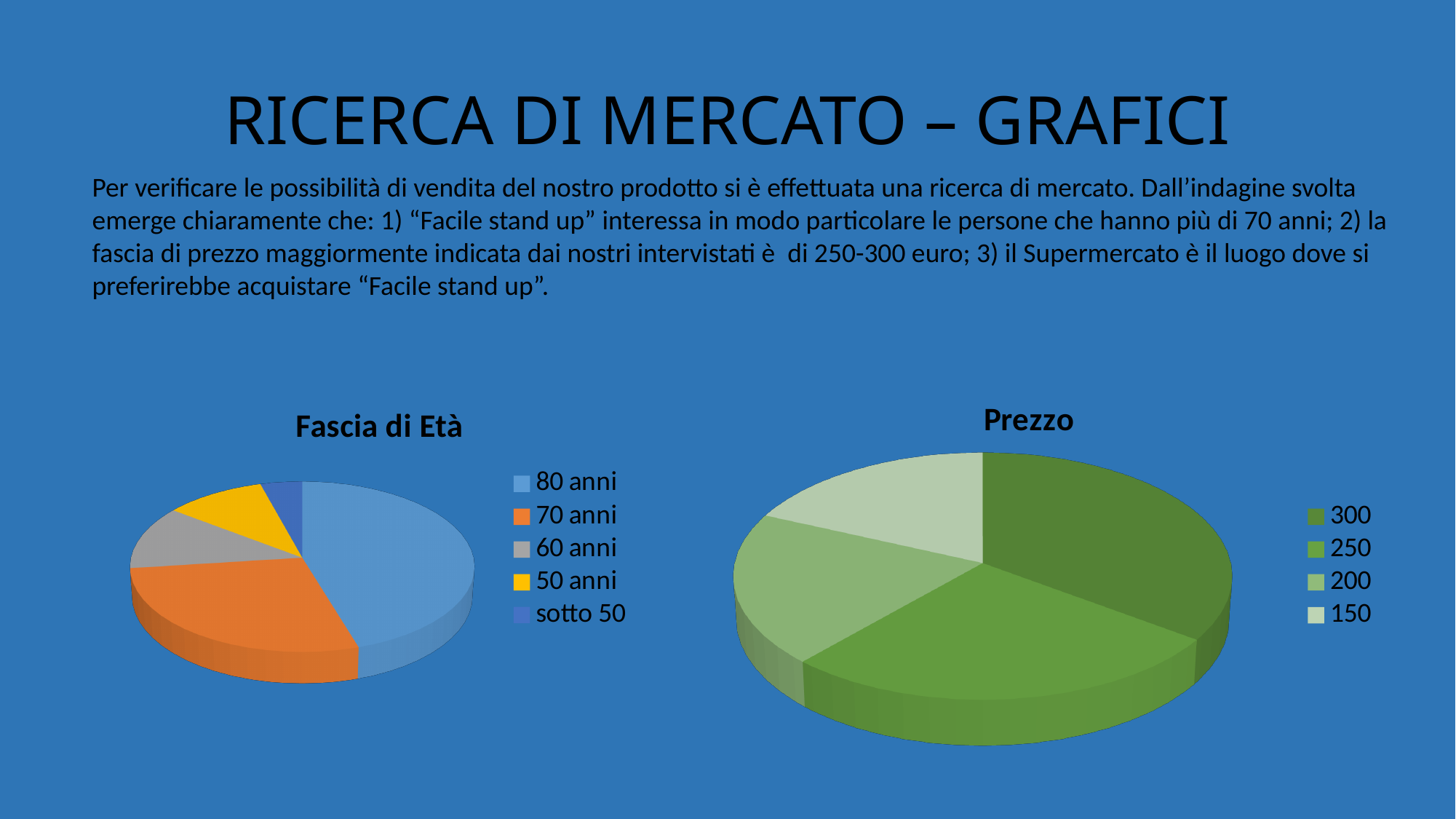
In the "Prezzo" chart, which slice is larger, 300 or 250? 300 In the "Fascia di Età" chart, how many categories does the legend list? 5 In the "Fascia di Età" chart, which category is shown in yellow? 50 anni In the "Prezzo" chart, which category has the largest slice? 300 In the "Fascia di Età" chart, which slice is larger, 80 anni or 70 anni? 80 anni In the "Fascia di Età" chart, which category has the largest slice? 80 anni What is the title of the chart on the right side of the slide? Prezzo What kind of chart is the "Fascia di Età" chart? pie chart In the "Fascia di Età" chart, which slice is larger, 70 anni or sotto 50? 70 anni In the "Fascia di Età" chart, which category has the smallest slice? sotto 50 What kind of chart is the "Prezzo" chart? pie chart In the "Prezzo" chart, how many categories does the legend list? 4